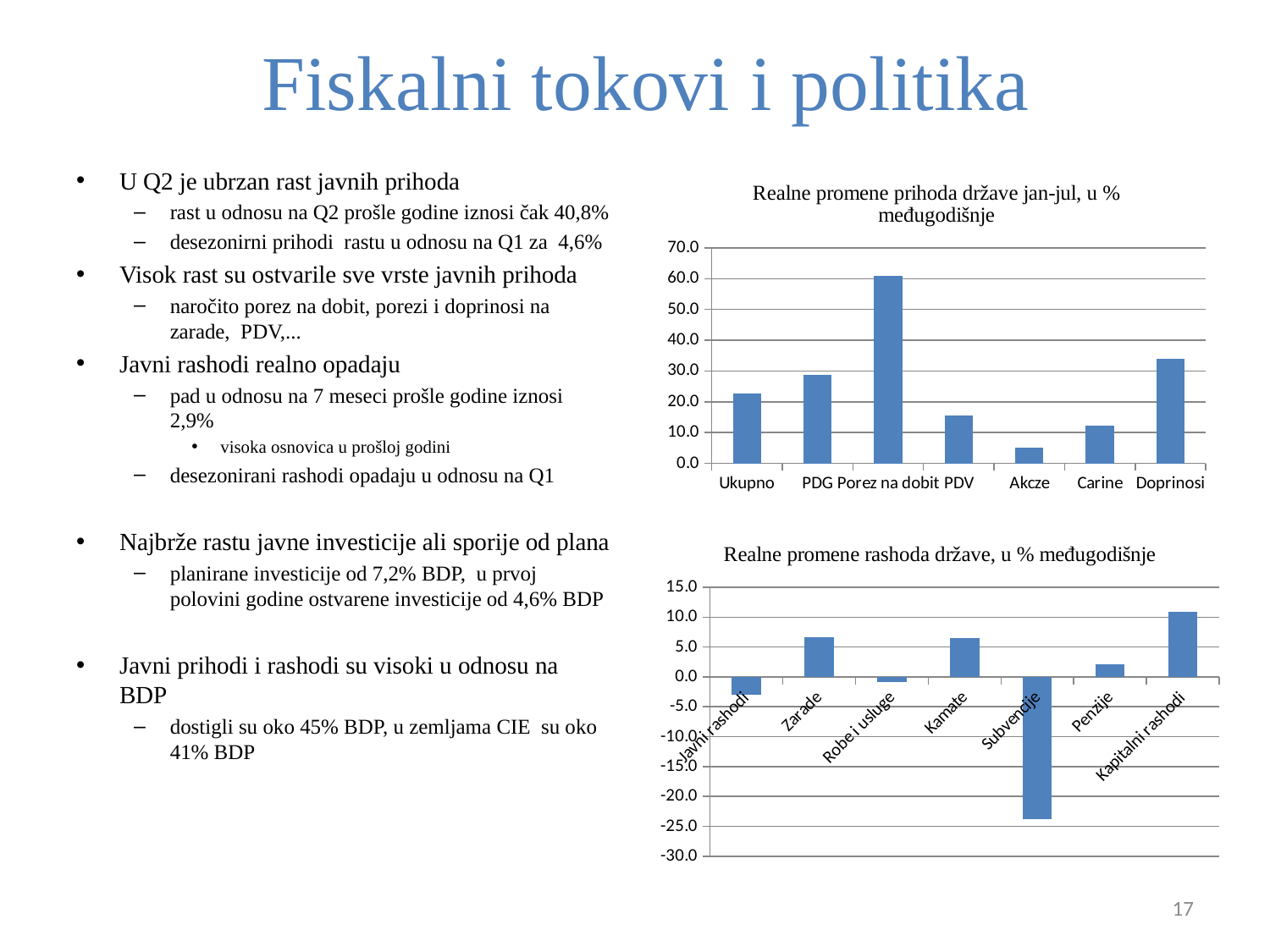
In the chart titled 'Realne promene rashoda države, u % međugodišnje', which category has the lowest value? Subvencije In the bottom chart, which is larger, the value for Penzije or the value for Javni rashodi? Penzije In the chart titled 'Realne promene prihoda države jan-jul, u % međugodišnje', which category has the highest value? Porez na dobit In the bottom chart, is the value for Kapitalni rashodi greater or less than 10.0? greater In the chart titled 'Realne promene rashoda države, u % međugodišnje', which category has the highest value? Kapitalni rashodi In the chart titled 'Realne promene prihoda države jan-jul, u % međugodišnje', which category has the lowest value? Akcze In the bottom chart, is the value for Subvencije greater or less than -20.0? less In the top chart, is the value for Porez na dobit greater or less than 50.0? greater What kind of chart is the top chart on the slide? bar chart In the top chart, which is larger, the value for Doprinosi or the value for PDG? Doprinosi How many categories are shown in the top chart? 7